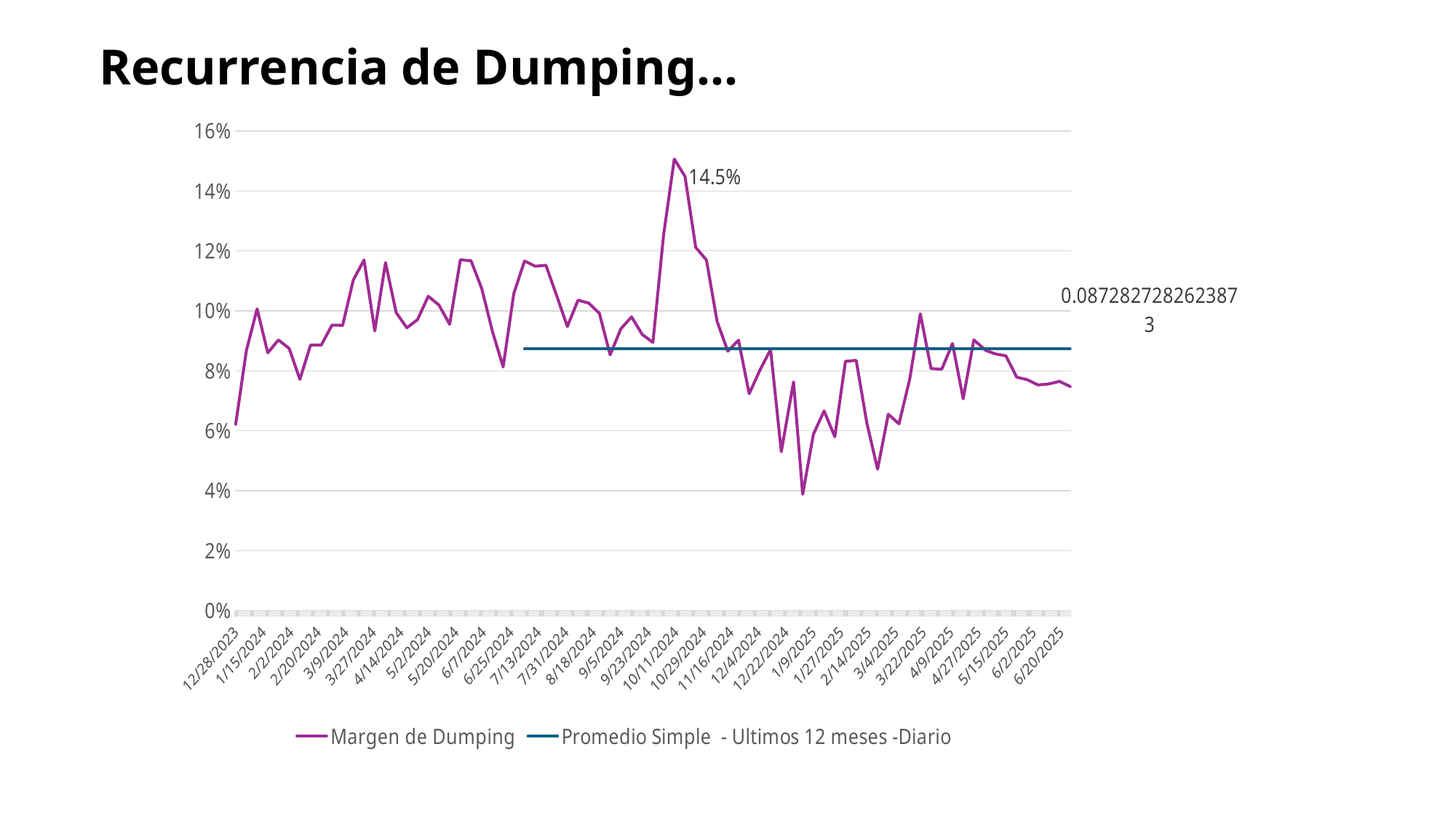
Is the value of Margen de Dumping at 12/28/2023 greater or less than 8%? less Is the highest point of the Margen de Dumping line greater or less than 14%? greater At 6/20/2025, is the Margen de Dumping line above or below the Promedio Simple - Ultimos 12 meses -Diario line? below What kind of chart is shown on the slide? line chart Which series is drawn as a flat horizontal line? Promedio Simple - Ultimos 12 meses -Diario What value is printed as a data label near the peak of the Margen de Dumping line? 14.5% Is the lowest point of the Margen de Dumping line, near 1/9/2025, greater or less than 6%? less What value is printed at the right end of the Promedio Simple - Ultimos 12 meses -Diario line? 0.0872827282623873 Between 10/11/2024 and 1/9/2025, does the Margen de Dumping line generally rise or fall? fall What is the title of the slide containing the chart? Recurrencia de Dumping... How many series does the legend list? 2